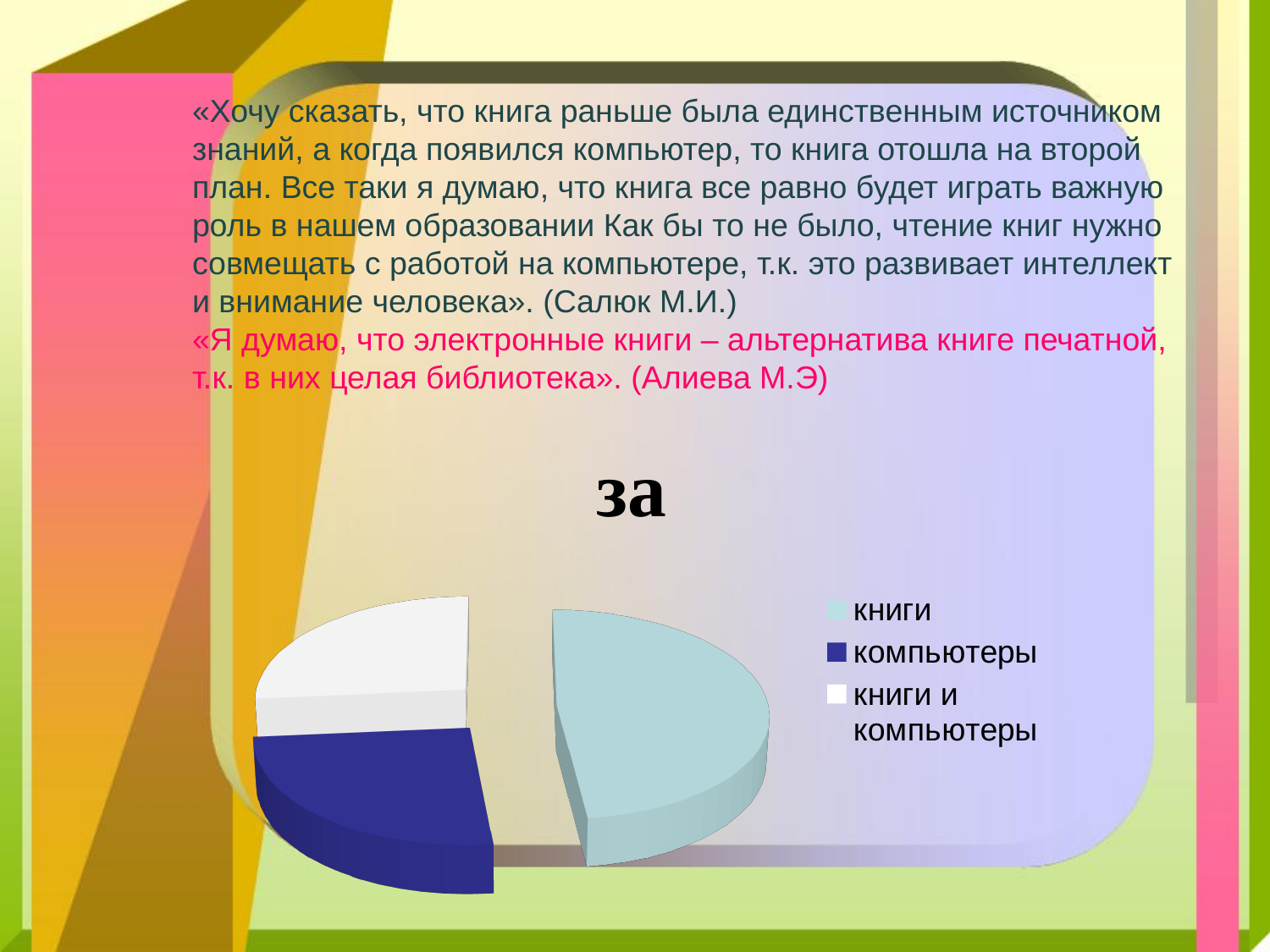
What kind of chart is shown on the slide? pie chart Which legend entry is shown in dark blue in the pie chart? компьютеры Which category has the largest slice in the pie chart? книги Which slice is larger in the pie chart, книги or книги и компьютеры? книги Which slice is larger in the pie chart, книги or компьютеры? книги How many entries does the legend of the pie chart list? 3 What is the title of the pie chart? за How many slices does the pie chart have? 3